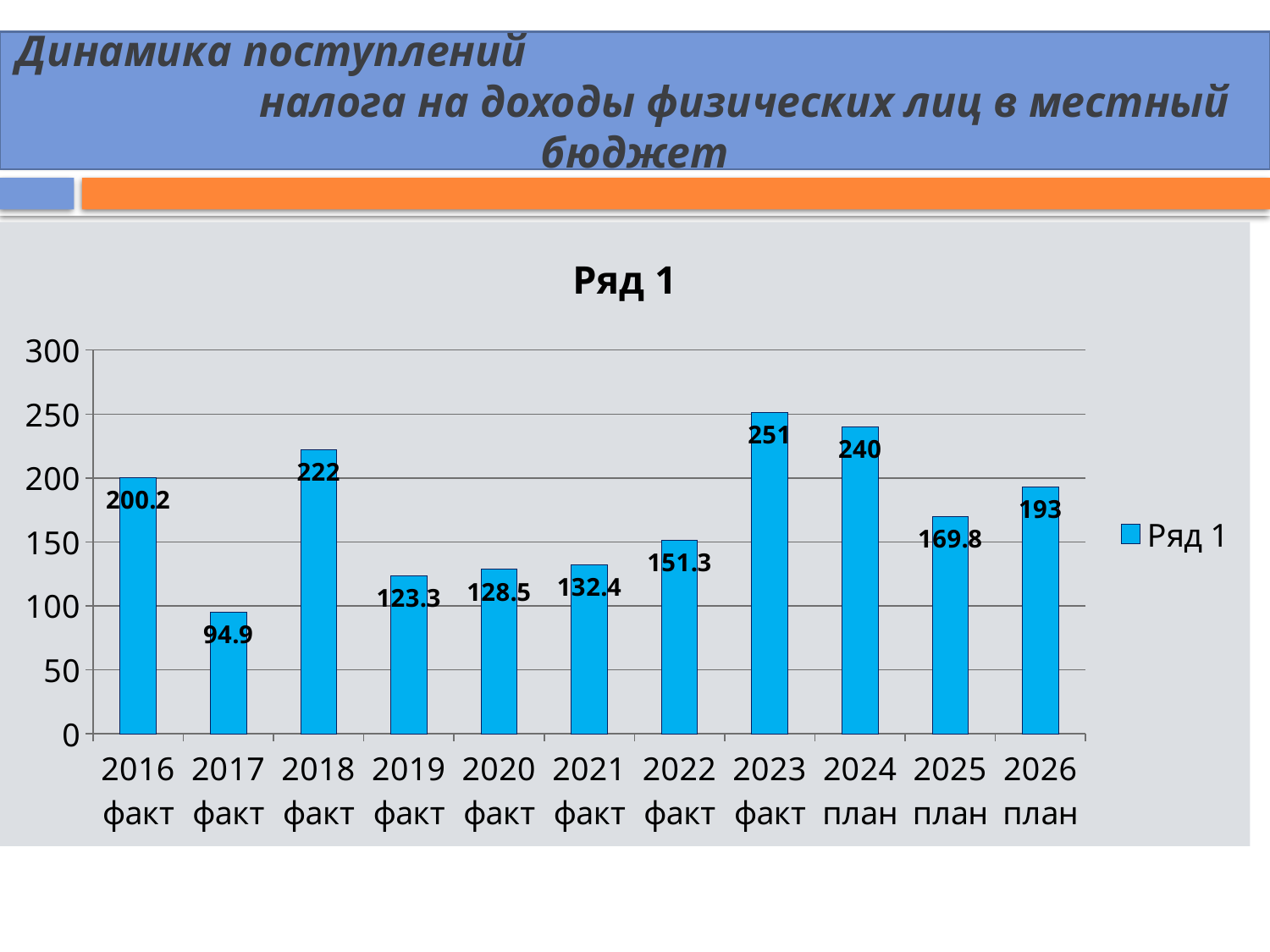
What is the difference between the values for 2018 факт and 2017 факт? 127.1 What is the value for 2016 факт? 200.2 Which category has the lowest value? 2017 факт What is the value for 2021 факт? 132.4 What kind of chart is shown on the slide? bar chart How many categories are shown on the x axis? 11 What is the value for 2024 план? 240 What is the difference between the values for 2023 факт and 2024 план? 11 Which category has the highest value? 2023 факт Which is larger, the value for 2025 план or the value for 2026 план? 2026 план What is the title of the chart? Ряд 1 Is the value for 2022 факт greater or less than 200? less